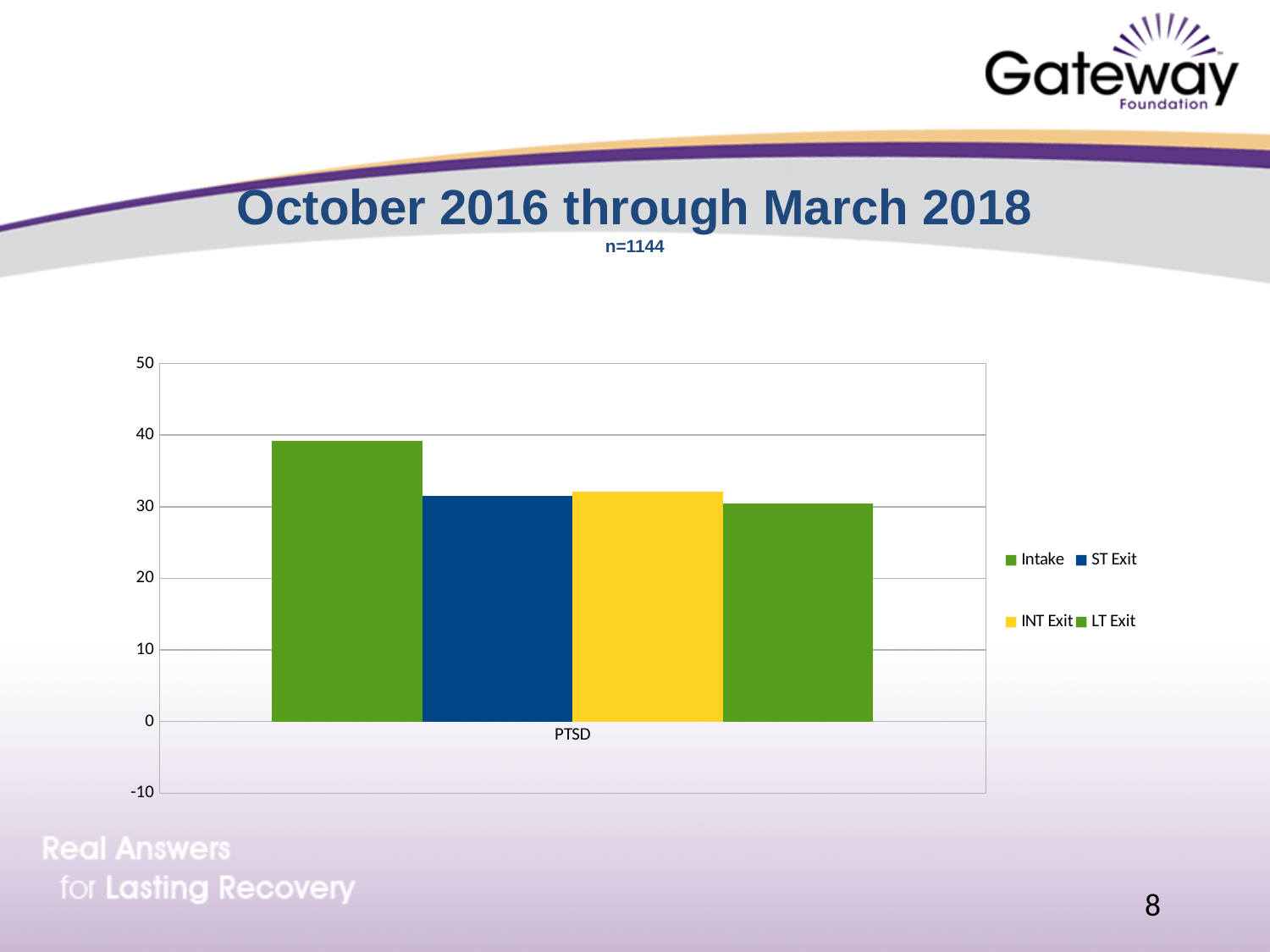
What is the category label shown on the x axis of the chart? PTSD What kind of chart is shown on the slide? bar chart How many categories are shown on the x axis of the chart? 1 Which series has the highest value for PTSD? Intake Which is larger for PTSD, the Intake value or the ST Exit value? Intake How many series does the chart's legend list? 4 Is the Intake value for PTSD greater or less than 30? greater Is the Intake value for PTSD greater or less than 40? less Which is larger for PTSD, the Intake value or the LT Exit value? Intake What colour represents the INT Exit series in the chart? yellow Is the ST Exit value for PTSD greater or less than 20? greater